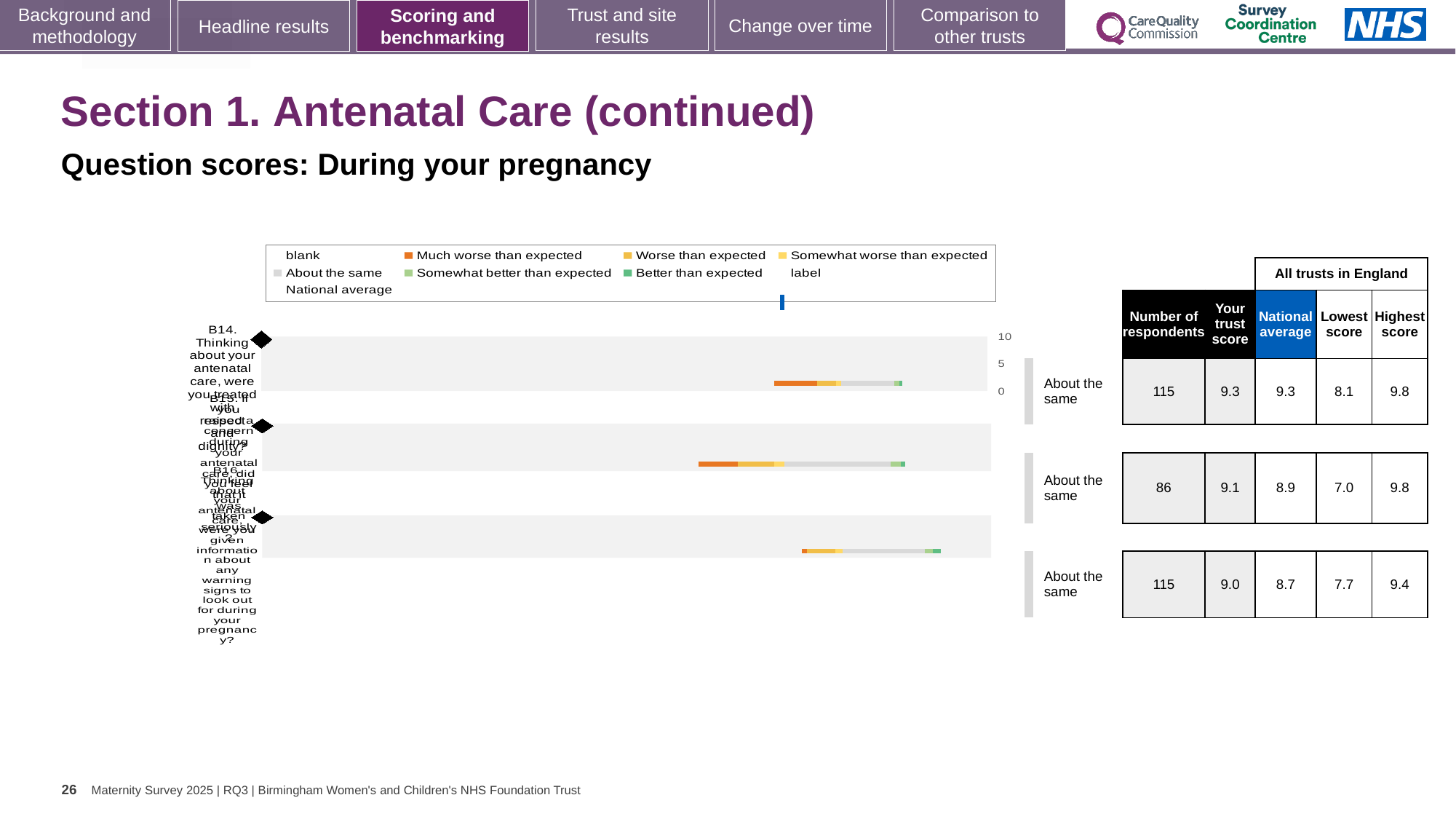
What is the highest score across all trusts in England for the second question (B15)? 9.8 How many question bars are plotted in the chart? 3 What kind of chart is shown on the slide? bar chart Which question has the highest 'Your trust score'? B14 (first question), 9.3 For the second question (B15), which is larger: the trust score or the national average? the trust score (9.1) What is the national average for the second question (B15)? 8.9 What is the number of respondents for the first question (B14, treated with respect and dignity)? 115 What is the lowest score across all trusts in England for the third question (B16, warning signs)? 7.7 What benchmark category is shown for all three questions? About the same For the third question (B16), what is the difference between the trust score and the national average? 0.3 What is the 'Your trust score' for the first question (B14)? 9.3 Which question has the lowest 'Lowest score' among all trusts in England? B15 (second question), 7.0